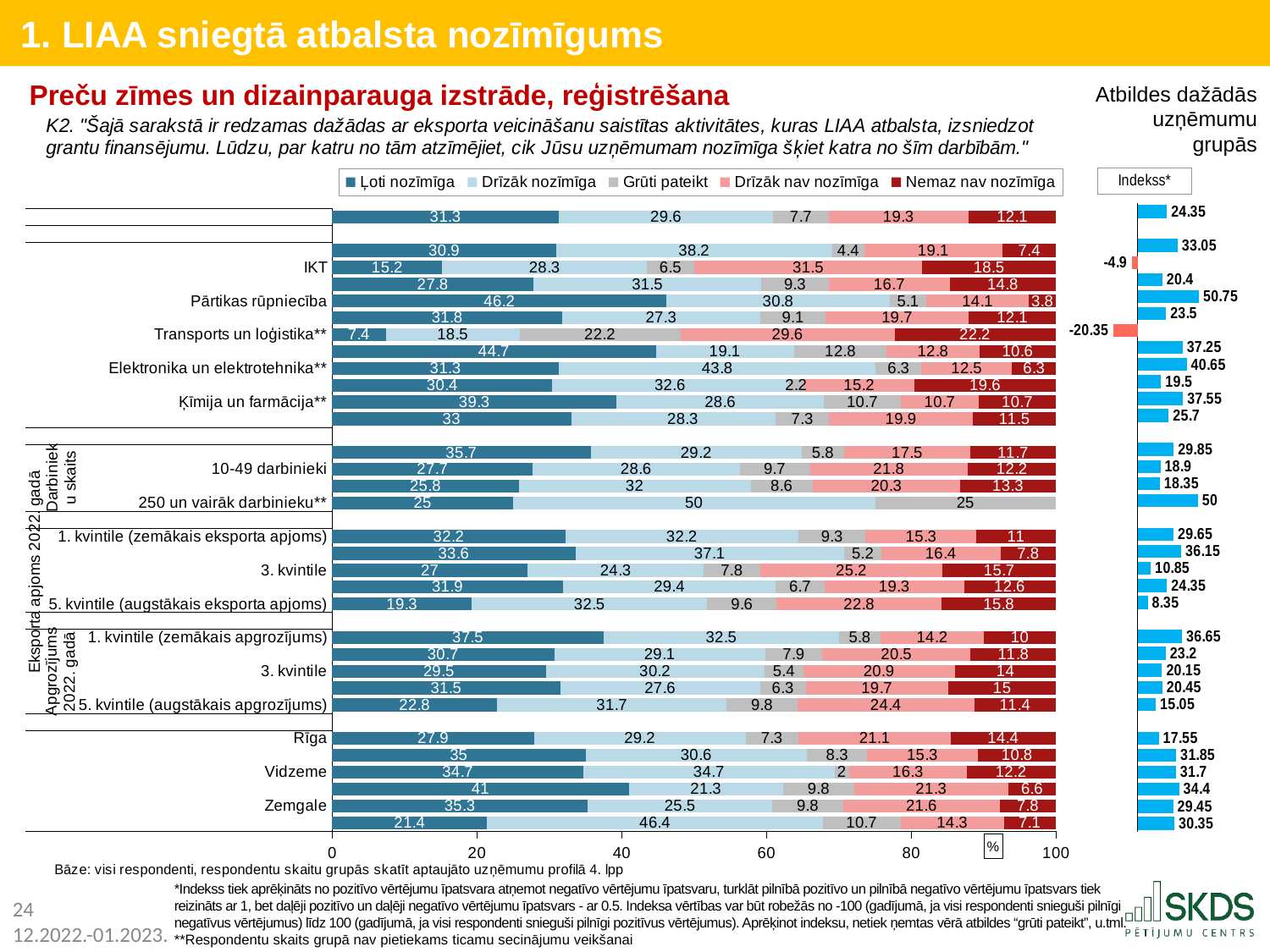
In the Indekss* chart, what is the index value for Rīga? 17.55 How many series does the legend of the main chart list? 5 What type of chart is used to show the distribution of answers on this slide? Stacked bar chart In the main chart, what is the value of "Drīzāk nozīmīga" for Elektronika un elektrotehnika**? 43.8 In the main chart, what is the value of "Grūti pateikt" for Transports un loģistika**? 22.2 In the main chart, what is the difference between the "Ļoti nozīmīga" values for Pārtikas rūpniecība and IKT? 31 In the Indekss* chart, what is the index value for Transports un loģistika**? -20.35 In the main chart, what is the value of "Drīzāk nav nozīmīga" for 10-49 darbinieki? 21.8 In the main chart, which has a larger "Ļoti nozīmīga" value: Rīga or Zemgale? Zemgale In the Indekss* chart, which labelled group has the lowest index value? Transports un loģistika** In the main chart, what is the value of "Ļoti nozīmīga" for Pārtikas rūpniecība? 46.2 In the main chart, what is the value of "Ļoti nozīmīga" for IKT? 15.2